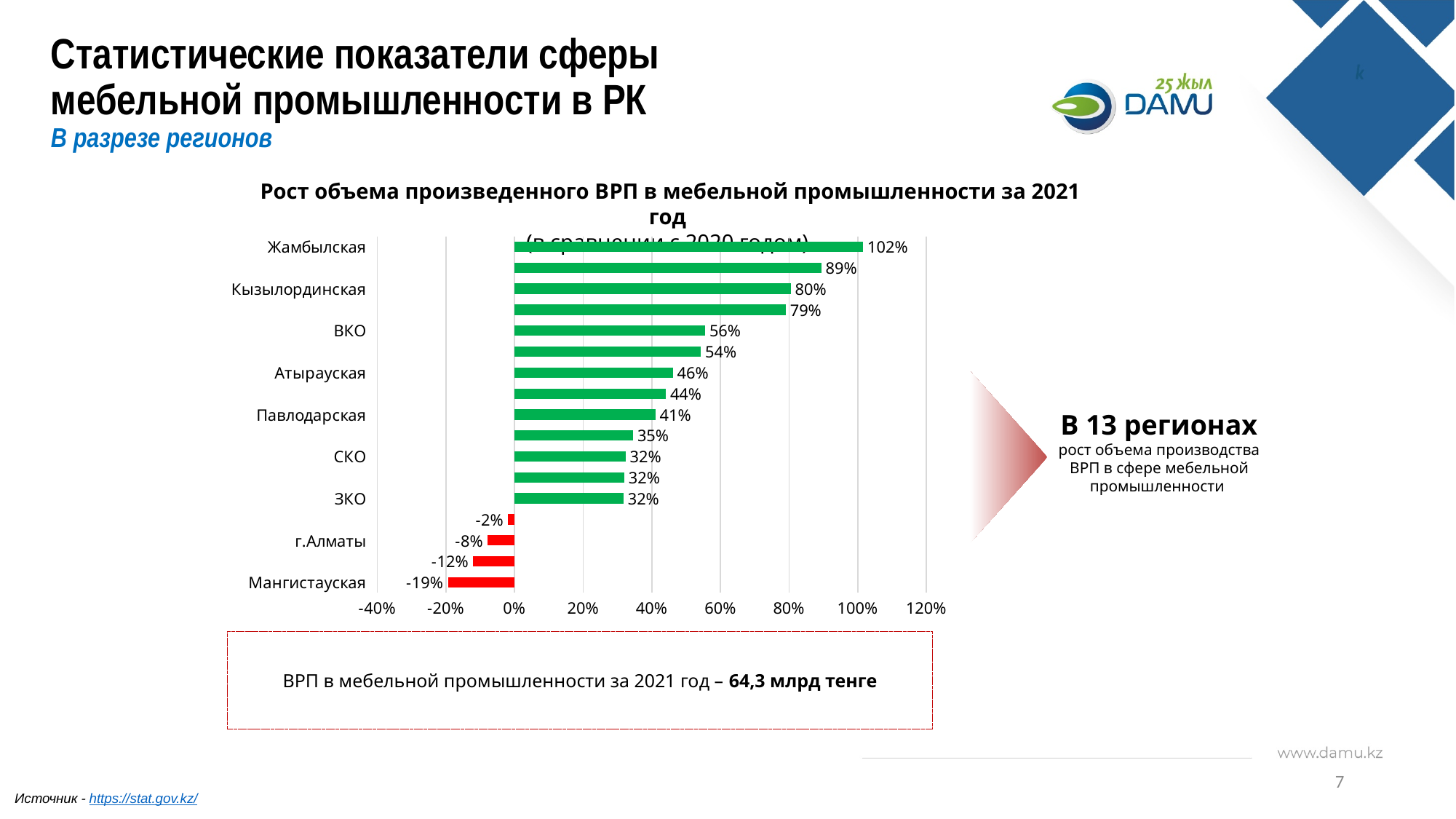
What is the value for Мангистауская? -19% What colour are the bars with negative values? Red What is the value for Жамбылская? 102% Which is larger, the value for Атырауская or the value for Павлодарская? Атырауская How many bars on the chart show a negative value? 4 What kind of chart is shown on the slide? Bar chart Which region has the highest value on the chart? Жамбылская What is the difference between the values for Жамбылская and Кызылординская? 22 percentage points How many bars are plotted on the chart? 17 What is the value for г.Алматы? -8% What is the value for ВКО? 56% Which region has the lowest value on the chart? Мангистауская